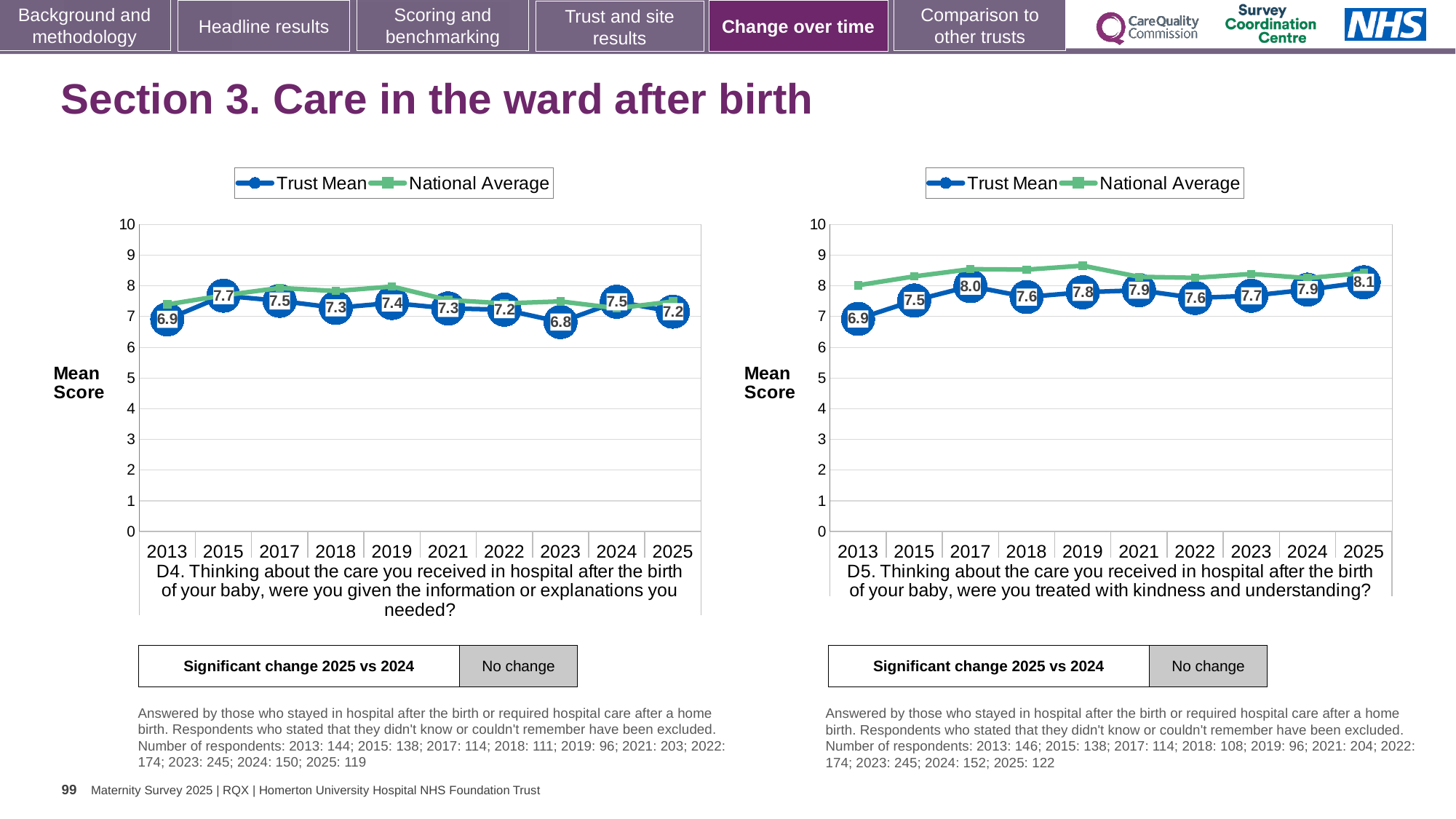
On the right chart (D5), what is the Trust Mean score for 2025? 8.1 What type of chart is the left chart (D4)? line chart On the right chart (D5), what is the difference between the Trust Mean scores for 2025 and 2013? 1.2 On the left chart (D4), which year has the highest Trust Mean score? 2015 On the right chart (D5), does the Trust Mean score rise or fall from 2013 to 2017? rise On the right chart (D5), which year has the lowest Trust Mean score? 2013 What does the box below the left chart (D4) say about the significant change 2025 vs 2024? No change On the left chart (D4), how many years are shown on the x axis? 10 On the right chart (D5), is the National Average value for 2019 greater or less than 8? greater On the left chart (D4), what is the Trust Mean score for 2023? 6.8 On the right chart (D5), how many series does the legend list? 2 On the left chart (D4), is the Trust Mean score for 2024 higher or lower than for 2025? higher